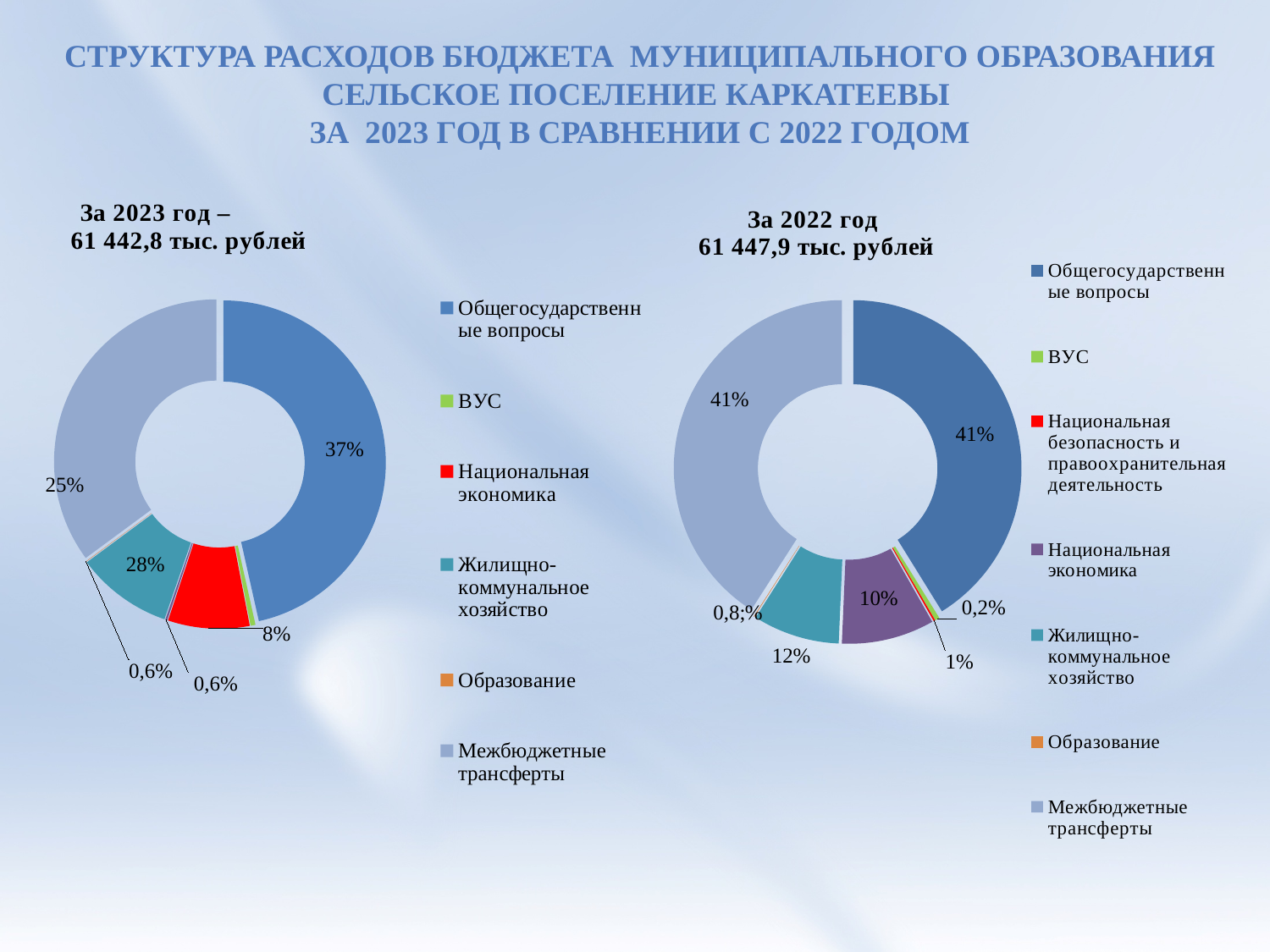
In the 2022 chart, what share is shown for Жилищно-коммунальное хозяйство? 12% In the 2022 chart, what is the difference between Жилищно-коммунальное хозяйство (12%) and Национальная экономика (10%)? 2 percentage points In the 2023 chart, what is the difference between the shares of Жилищно-коммунальное хозяйство (28%) and Межбюджетные трансферты (25%)? 3 percentage points In the 2023 chart, which category has the largest share? Общегосударственные вопросы In the 2022 chart, what share is shown for Национальная экономика? 10% How many categories does the legend of the 2022 chart list? 7 What kind of chart is used on the left for 2023? Doughnut (pie) chart In the 2023 chart, what share is shown for Общегосударственные вопросы? 37% In the 2023 chart, what share is shown for Межбюджетные трансферты? 25% In the 2023 chart, what share is shown for Жилищно-коммунальное хозяйство? 28% What total expenditure amount is given in the title of the 2023 chart? 61 442,8 тыс. рублей